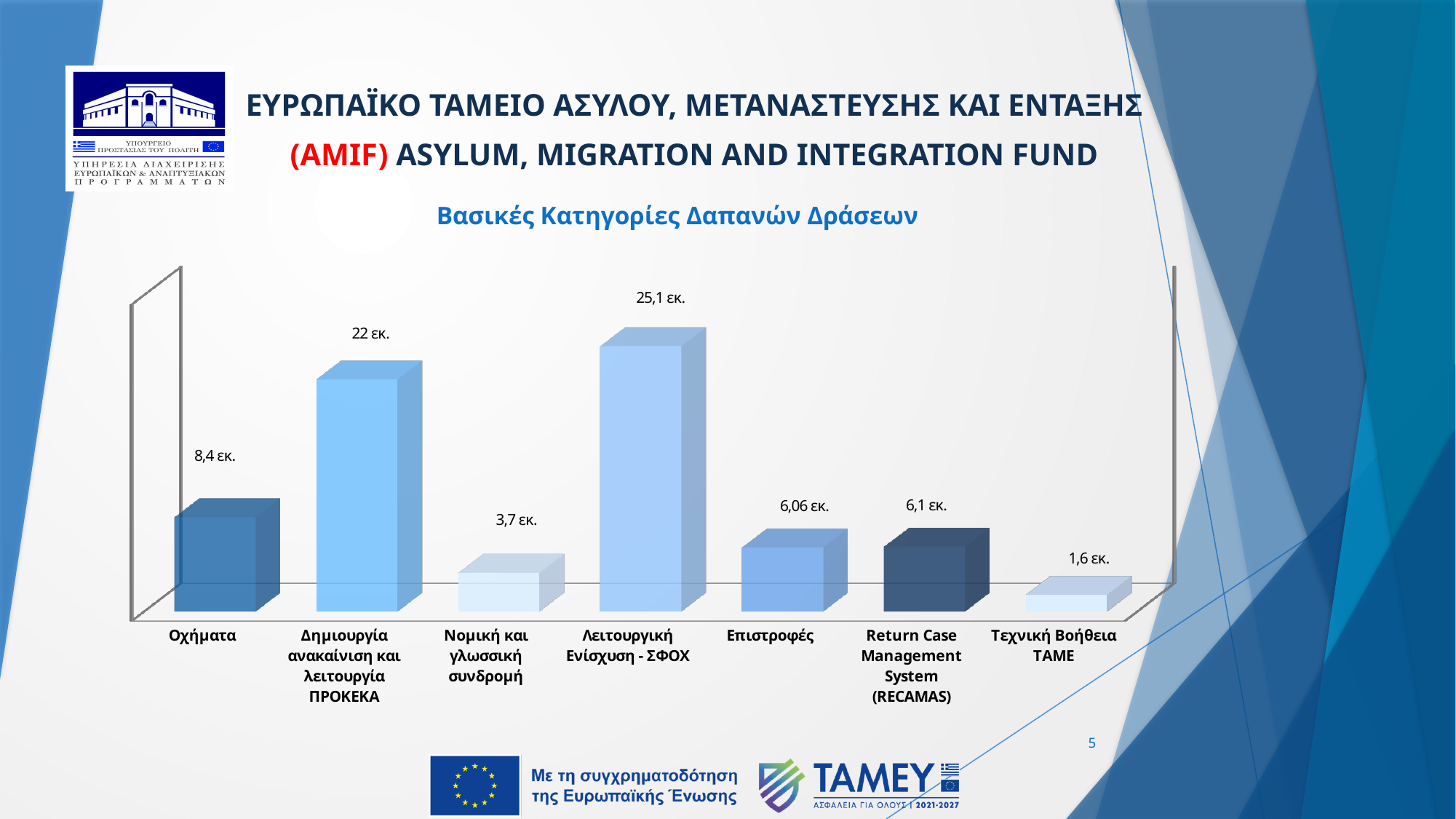
Which category has the lowest value? Τεχνική Βοήθεια ΤΑΜΕ Which category has the highest value? Λειτουργική Ενίσχυση - ΣΦΟΧ What is the value for Επιστροφές? 6,06 εκ. What is the value for Οχήματα? 8,4 εκ. How many categories are shown in the chart? 7 What is the value for Τεχνική Βοήθεια ΤΑΜΕ? 1,6 εκ. What is the title of the chart? Βασικές Κατηγορίες Δαπανών Δράσεων Which is larger, the value for Οχήματα or the value for Νομική και γλωσσική συνδρομή? Οχήματα What is the difference between the values for Οχήματα and Νομική και γλωσσική συνδρομή? 4,7 εκ. What is the difference between the values for Λειτουργική Ενίσχυση - ΣΦΟΧ and Δημιουργία ανακαίνιση και λειτουργία ΠΡΟΚΕΚΑ? 3,1 εκ. What type of chart is shown on the slide? Bar chart What is the value for Λειτουργική Ενίσχυση - ΣΦΟΧ? 25,1 εκ.